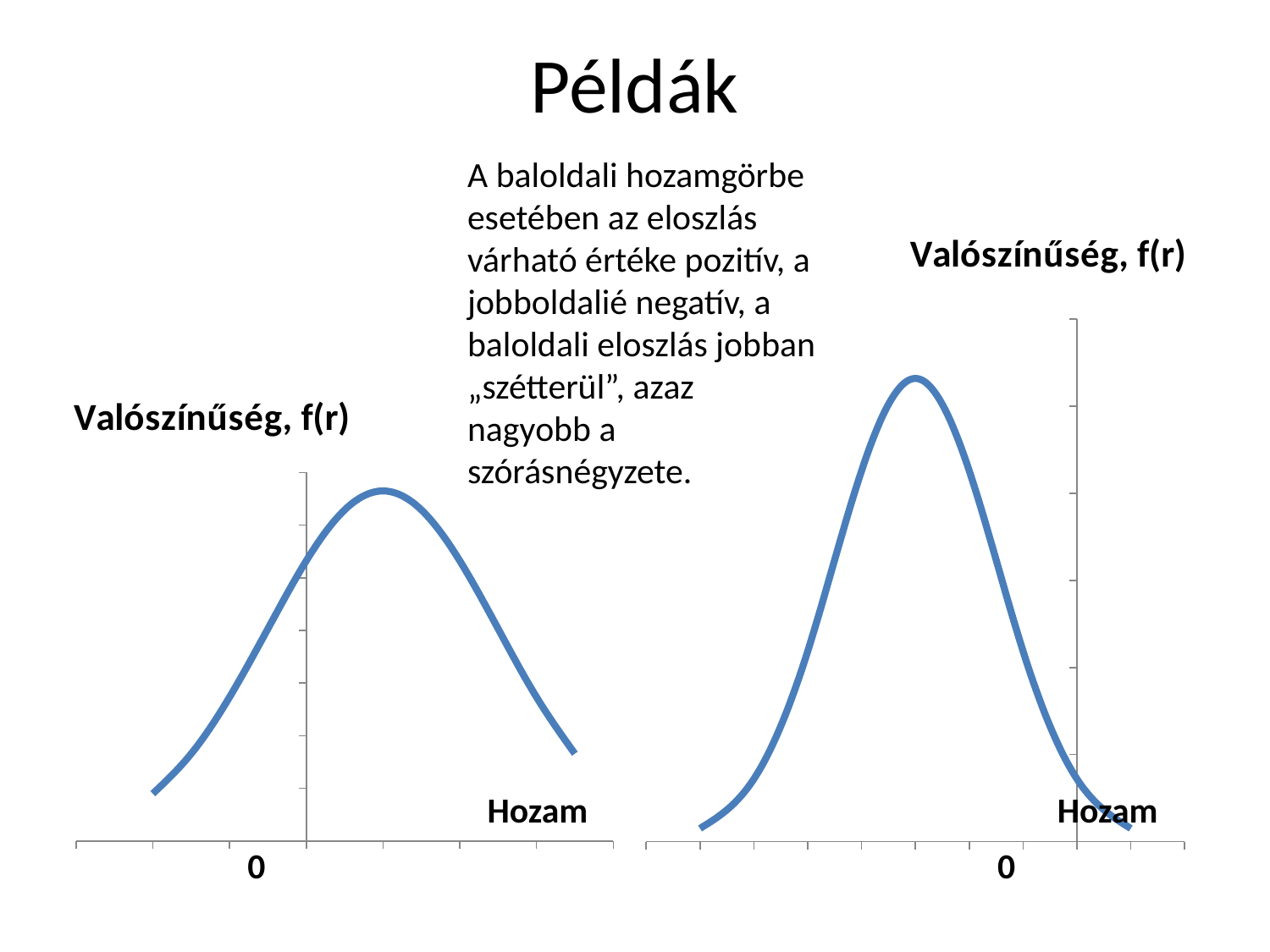
In the right chart, does the curve rise or fall as it moves from the peak toward the right edge? fall What kind of chart is the left chart on the slide? line chart What kind of chart is the right chart on the slide? line chart What is the y-axis label of the right chart? Valószínűség, f(r) What is the x-axis label of the left chart? Hozam How many charts are shown on the slide? 2 How many lines are plotted in the right chart? 1 In the left chart, is the peak of the curve to the left or to the right of the 0 mark on the x axis? right How many lines are plotted in the left chart? 1 In the left chart, does the curve rise or fall as it moves from the left edge toward the 0 mark on the x axis? rise In the right chart, is the peak of the curve to the left or to the right of the 0 mark on the x axis? left